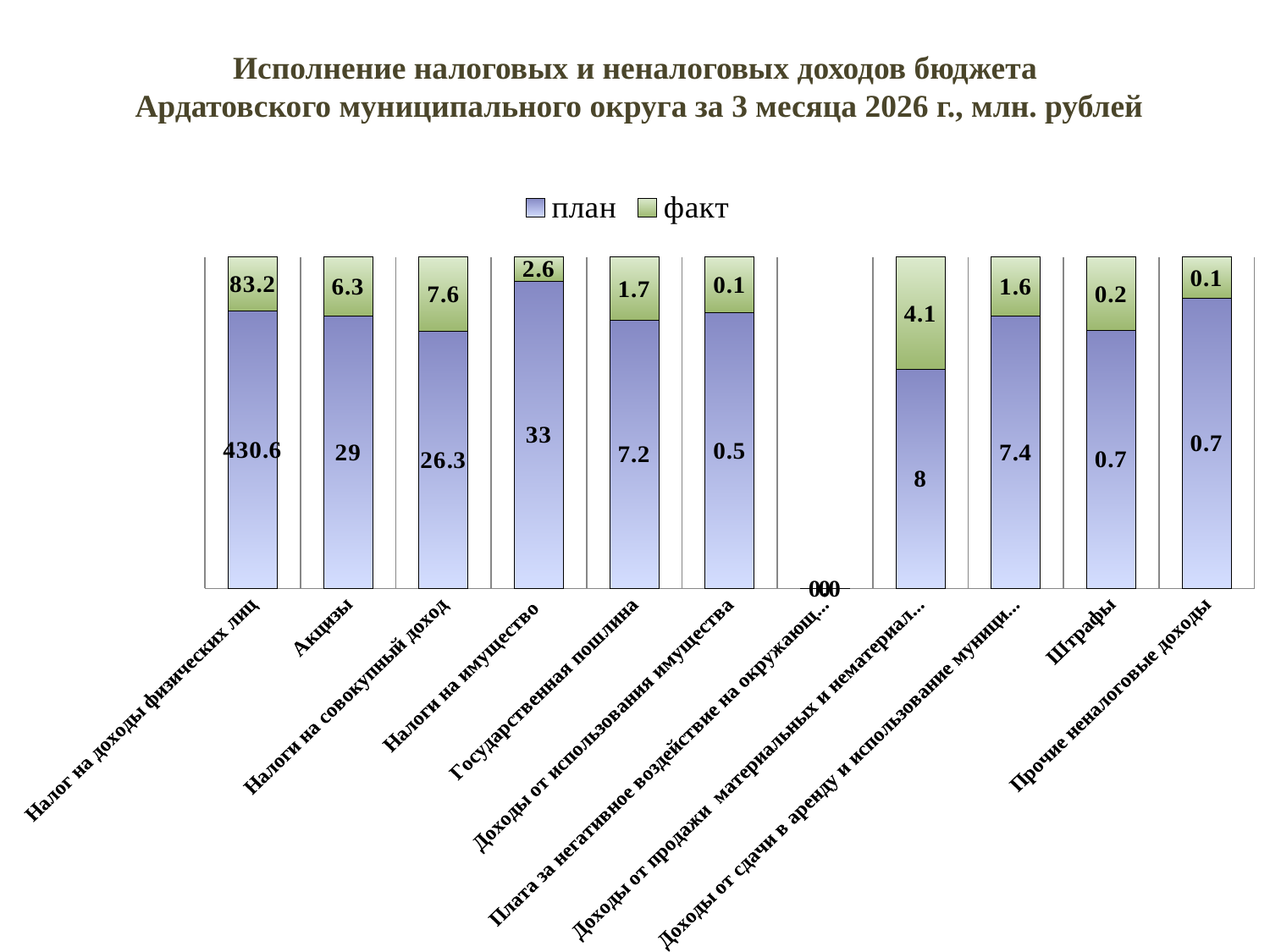
What is the difference between the план and факт values for Акцизы? 22.7 What is the total of план and факт for Государственная пошлина? 8.9 What kind of chart is shown on the slide? Bar chart Which category has the highest план value? Налог на доходы физических лиц Which is larger, the план value for Налоги на имущество or the план value for Акцизы? Налоги на имущество How many categories are shown on the x axis? 11 What is the план value for Налог на доходы физических лиц? 430.6 What is the план value for Доходы от продажи материальных и нематериал...? 8 What is the факт value for Налоги на совокупный доход? 7.6 What is the факт value for Штрафы? 0.2 Which category has the highest факт value? Налог на доходы физических лиц How many series does the legend list? 2